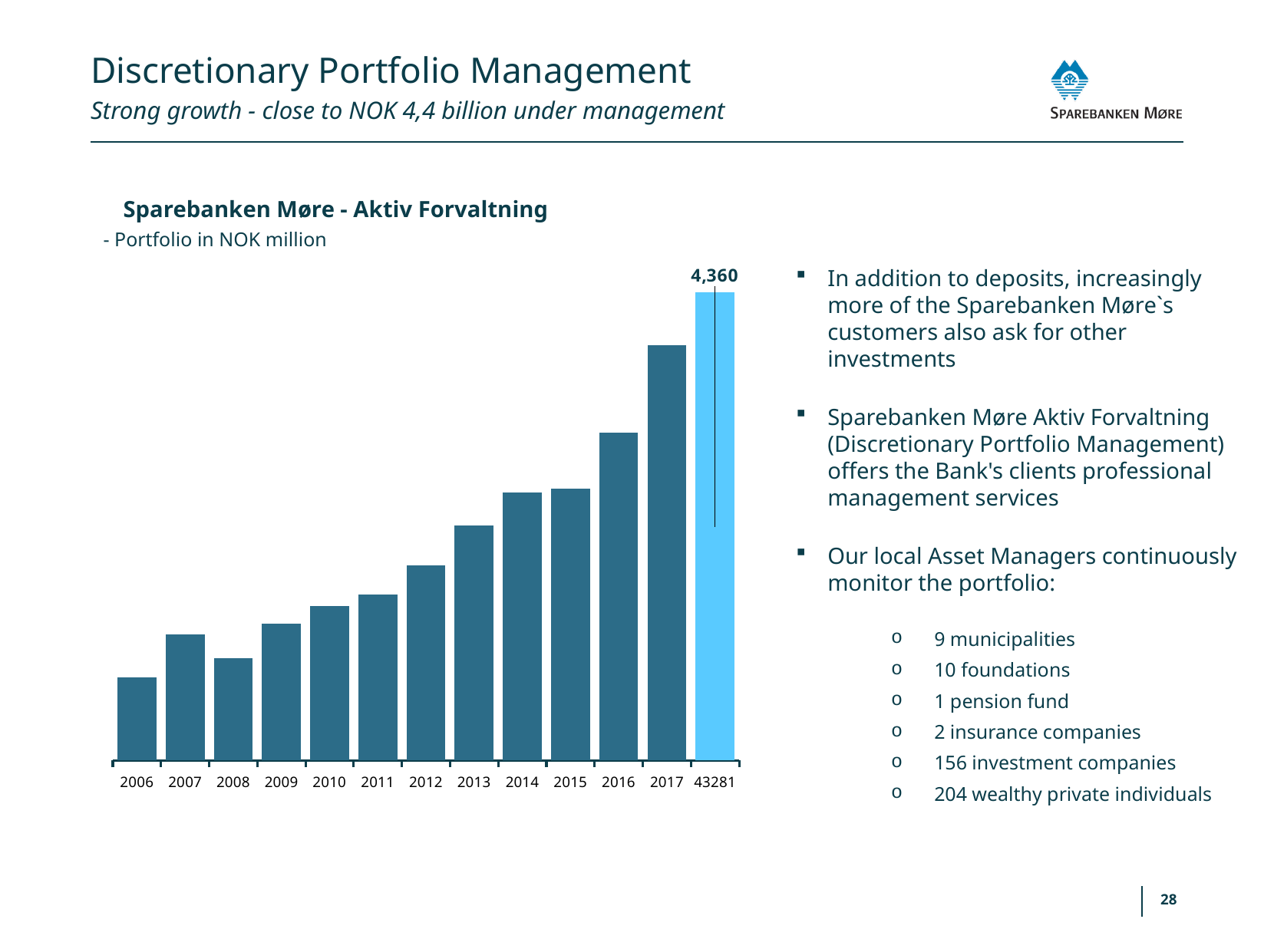
Which bar is taller, 2010 or 2013? 2013 Which category has the highest bar in the chart? 43281 How many bars are plotted in the chart? 13 Which bar is taller, 2007 or 2008? 2007 Which is the only bar with a printed data label in the chart? 43281 Which bar is taller, 2016 or 2017? 2017 What is the value of the bar labelled 43281 in the chart? 4,360 What is the title of the chart? Sparebanken Møre - Aktiv Forvaltning What type of chart is shown on the slide? Bar chart Which year has the lowest bar in the chart? 2006 Do the values generally rise or fall from 2009 to 43281 along the x axis? Rise In what unit are the portfolio values in the chart expressed? NOK million